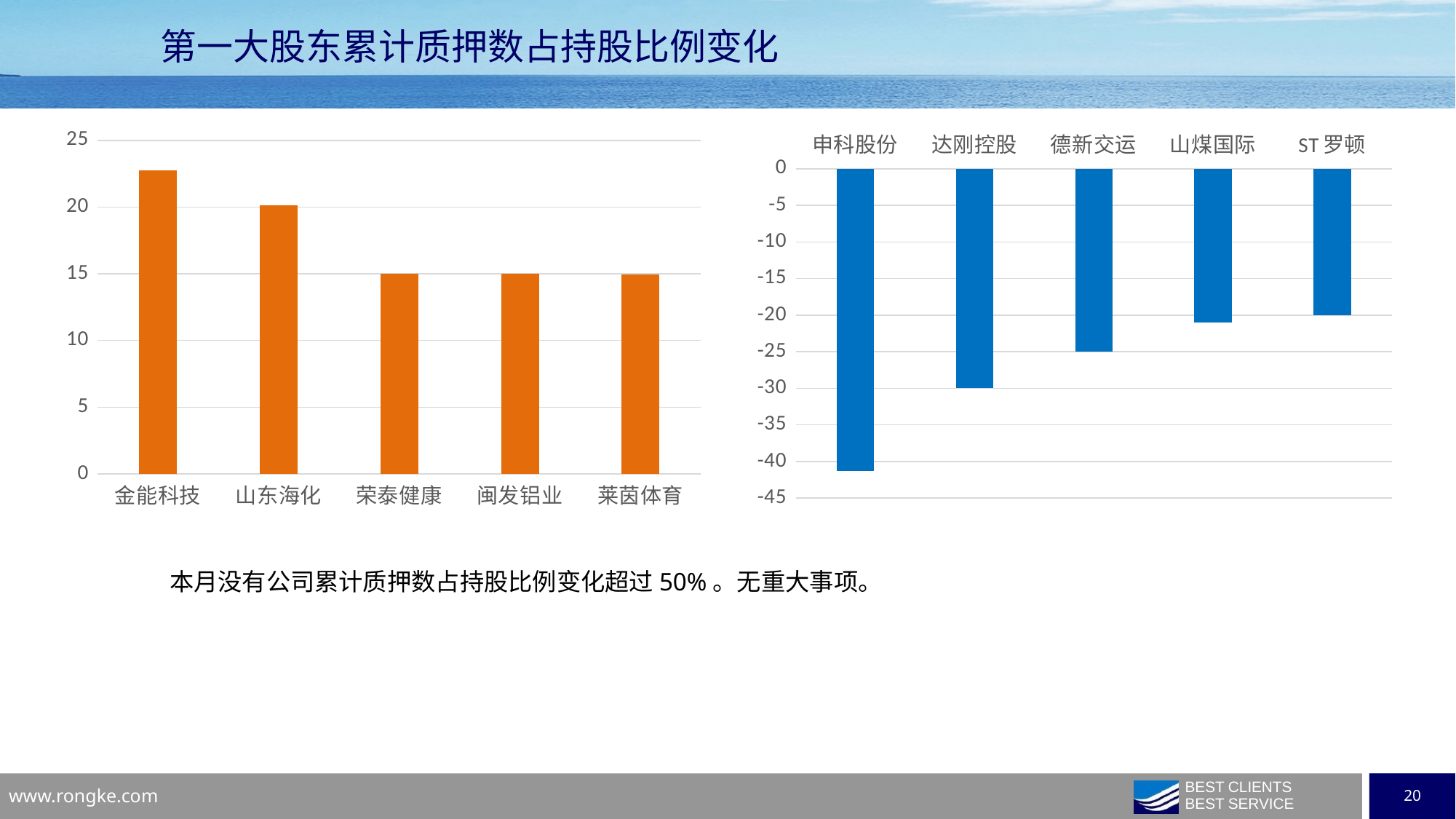
In the left (orange) chart, which is larger, the value for 山东海化 or the value for 闽发铝业? 山东海化 In the right (blue) chart, is the value for 德新交运 greater or less than -30? greater In the right (blue) chart, which category has the lowest (most negative) value? 申科股份 What kind of chart is the left chart on the slide? bar chart How many categories are shown in the left (orange) chart? 5 In the left (orange) chart, which category has the highest value? 金能科技 How many categories are shown in the right (blue) chart? 5 What colour are the bars in the right chart? blue In the right (blue) chart, is the value for 申科股份 greater or less than -40? less In the right (blue) chart, do the values rise or fall from left to right along the x axis? rise In the left (orange) chart, is the value for 荣泰健康 greater or less than 20? less